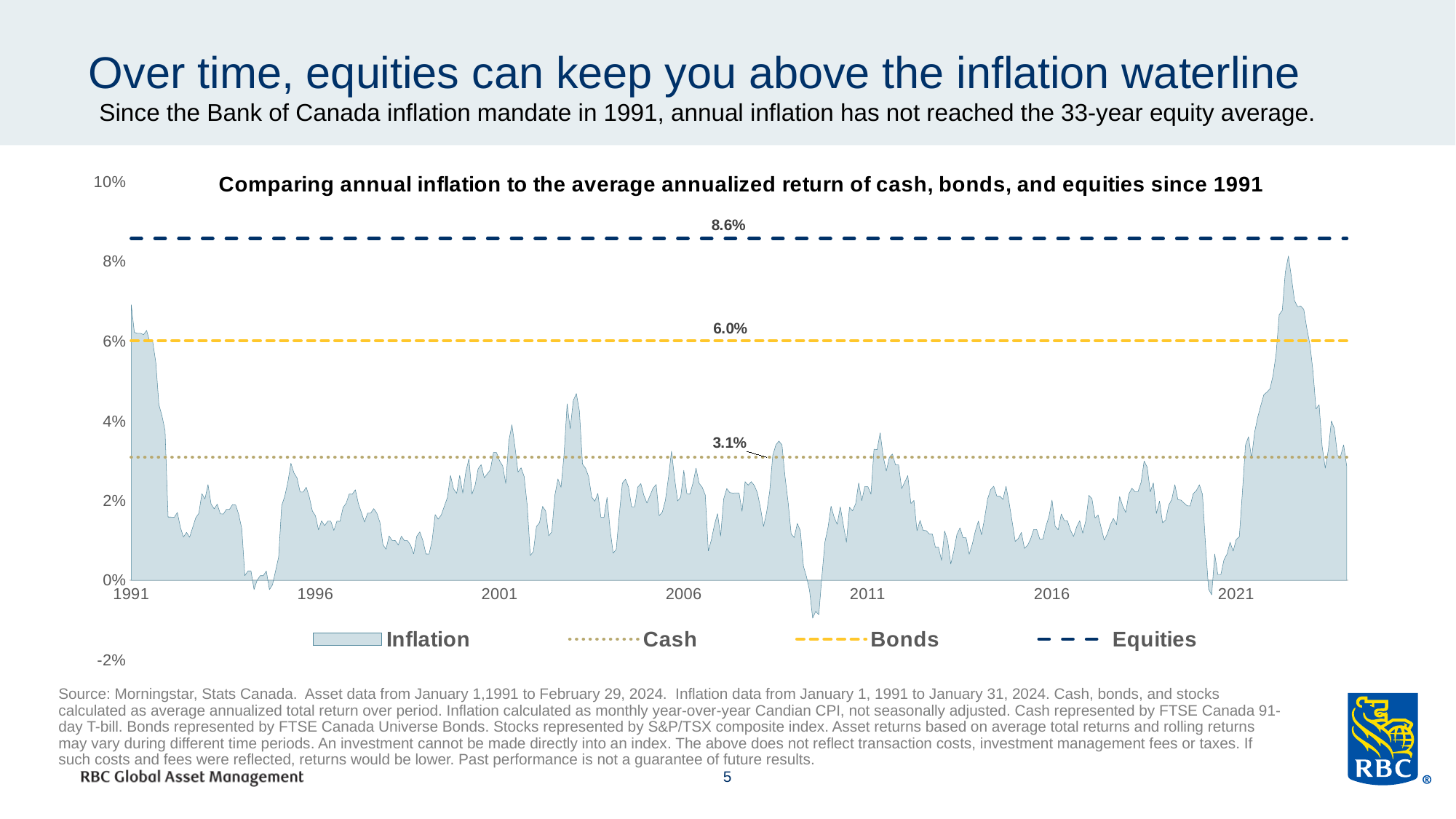
What is the difference between the Equities and Bonds average annualized returns? 2.6% What is the average annualized return shown for Cash? 3.1% Which is larger, the average annualized return for Bonds or for Cash? Bonds Is the peak inflation value around 2022 greater or less than 6%? greater Which asset class has the lowest average annualized return on the chart? Cash What is the difference between the Bonds and Cash average annualized returns? 2.9% Which asset class has the highest average annualized return on the chart? Equities How many series does the legend list? 4 What is the title of the chart? Comparing annual inflation to the average annualized return of cash, bonds, and equities since 1991 What is the average annualized return shown for Bonds? 6.0% What is the average annualized return shown for Equities? 8.6% What kind of chart is used to show inflation? area chart